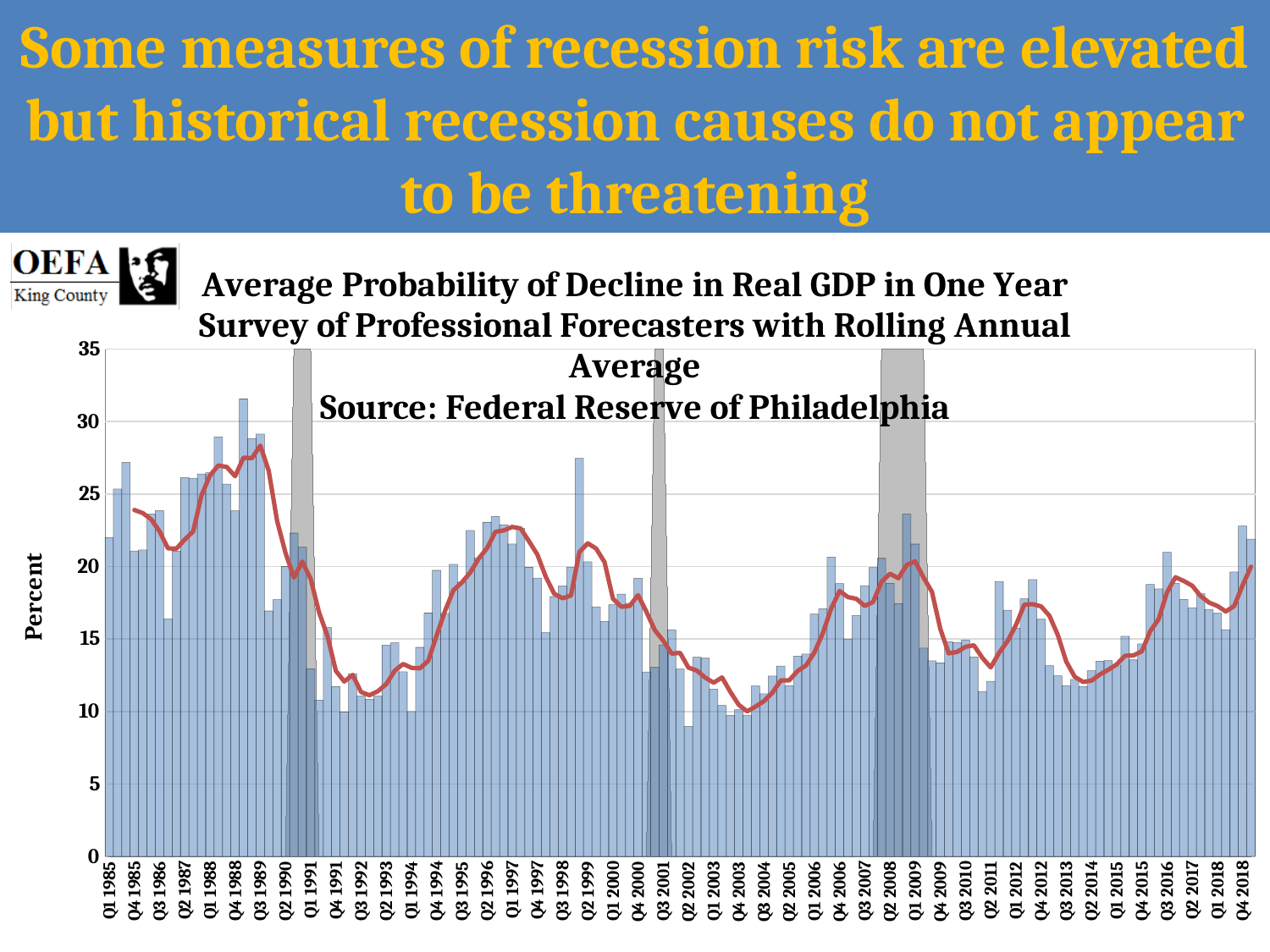
Is the value for Q3 1989 greater or less than 25? greater Is the value for Q1 2009 greater or less than 20? greater What is the label on the vertical axis of the chart? Percent Is the value for Q2 1999 greater or less than 25? less What kind of chart is shown on the slide? bar chart Which quarter has the highest bar in the chart? Q1 1989 Which is larger, the value for Q1 1985 or the value for Q4 2003? Q1 1985 According to the chart title, what is the source of the data? Federal Reserve of Philadelphia